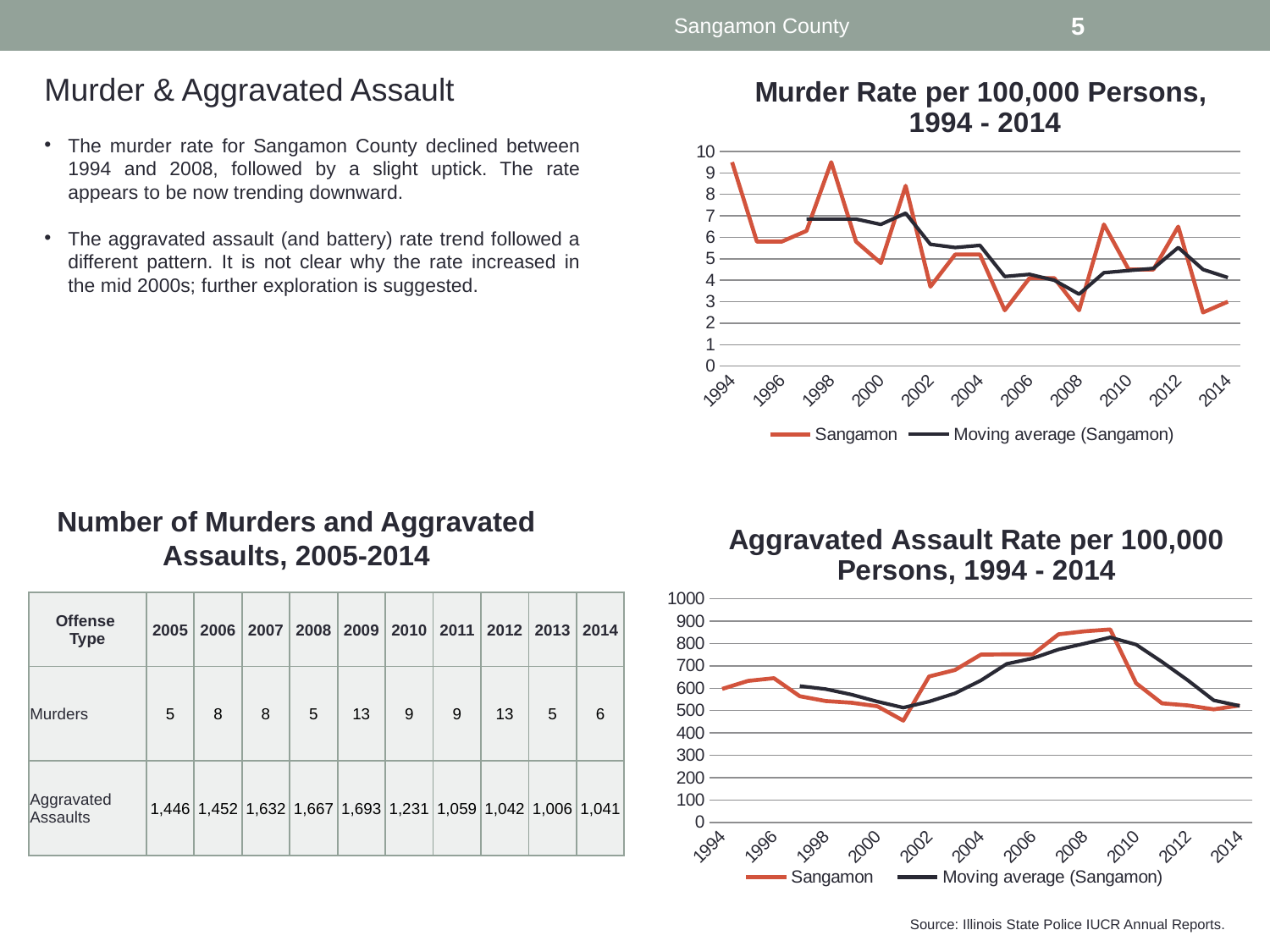
In the 'Murder Rate per 100,000 Persons, 1994 - 2014' chart, is the Sangamon value for 1994 greater or less than 9? greater How many series does the legend of the 'Murder Rate per 100,000 Persons, 1994 - 2014' chart list? 2 In the 'Aggravated Assault Rate per 100,000 Persons, 1994 - 2014' chart, which year has the lowest Sangamon value? 2001 In the 'Murder Rate per 100,000 Persons, 1994 - 2014' chart, is the Sangamon value for 2013 greater or less than 3? less In the 'Murder Rate per 100,000 Persons, 1994 - 2014' chart, does the Sangamon murder rate overall rise or fall from 1994 to 2014? fall In the 'Murder Rate per 100,000 Persons, 1994 - 2014' chart, is the Sangamon value for 2010 greater or less than 6? less What kind of chart is the 'Aggravated Assault Rate per 100,000 Persons, 1994 - 2014' chart? Line chart In the 'Aggravated Assault Rate per 100,000 Persons, 1994 - 2014' chart, what are the two legend entries? Sangamon; Moving average (Sangamon) What kind of chart is the 'Murder Rate per 100,000 Persons, 1994 - 2014' chart? Line chart In the 'Murder Rate per 100,000 Persons, 1994 - 2014' chart, which is larger for the Sangamon series: the value for 1994 or the value for 2014? 1994